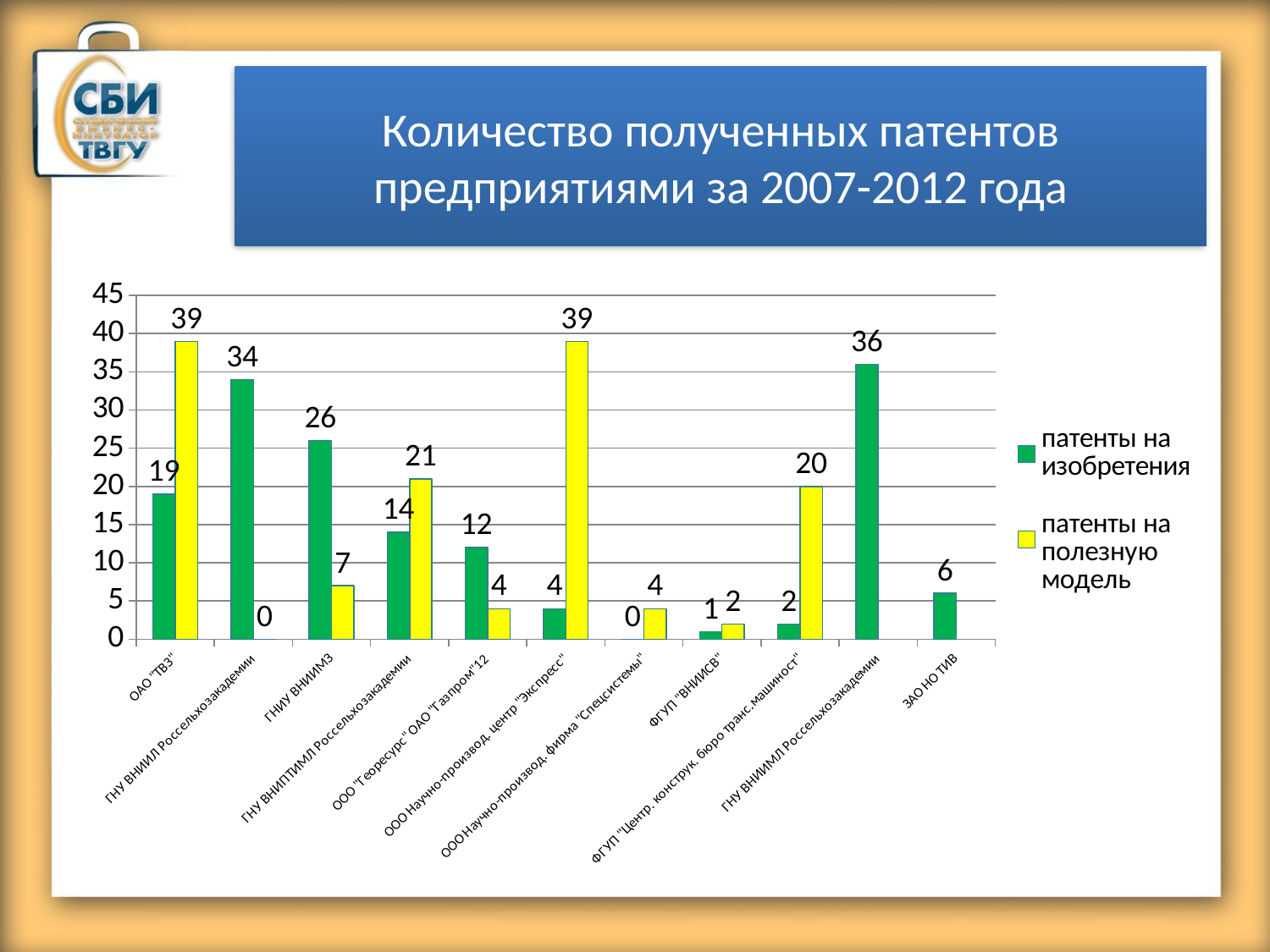
How many патенты на полезную модель does ОАО "ТВЗ" have? 39 What is the difference between патенты на полезную модель and патенты на изобретения for ООО Научно-производ. центр "Экспресс"? 35 How many патенты на изобретения does ГНИУ ВНИИМЗ have? 26 How many series does the legend list? 2 What is the total of патенты на изобретения and патенты на полезную модель for ОАО "ТВЗ"? 58 What colour represents патенты на полезную модель in the chart? yellow For ГНУ ВНИПТИМЛ Россельхозакадемии, which is larger: патенты на изобретения or патенты на полезную модель? патенты на полезную модель How many enterprises (categories) are shown on the x axis? 11 What type of chart is shown on the slide? bar chart How many патенты на полезную модель does ФГУП "Центр. конструк. бюро транс.машиност" have? 20 Which enterprise has the lowest number of патенты на изобретения? ООО Научно-производ. фирма "Спецсистемы" Which enterprise has the highest number of патенты на изобретения? ГНУ ВНИИМЛ Россельхозакадемии